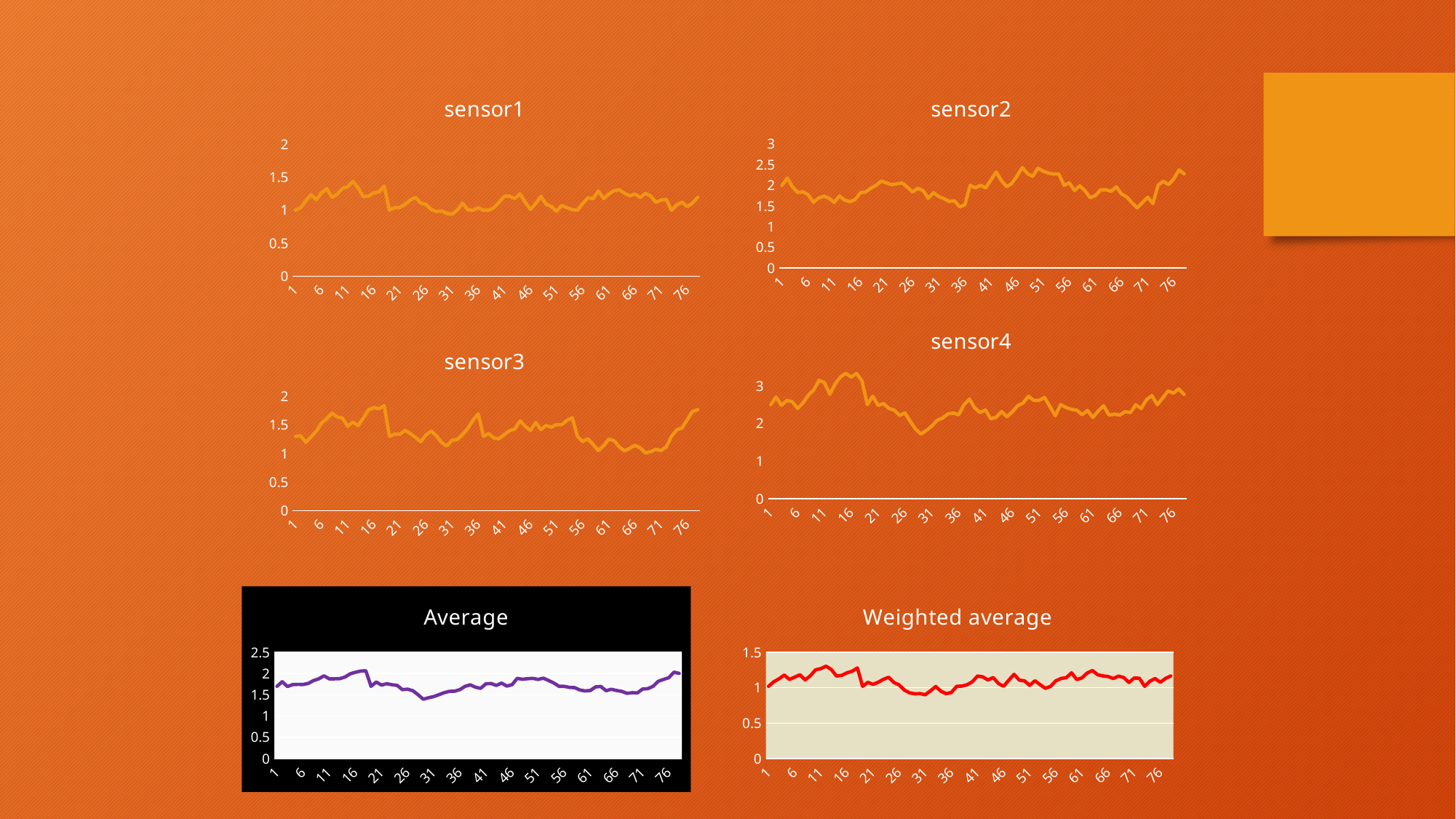
In the Weighted average chart, is the value at point 1 greater or less than 0.5? greater In the sensor1 chart, is the value at point 1 greater or less than 1.5? less What kind of chart is the sensor1 chart? line chart How many charts are shown on the slide? 6 In the sensor4 chart, is the value at point 16 greater or less than 2? greater In the sensor4 chart, does the line rise or fall between points 16 and 31? fall In the sensor3 chart, does the line rise or fall between points 66 and 76? rise What is the highest value shown on the y axis of the sensor2 chart? 3